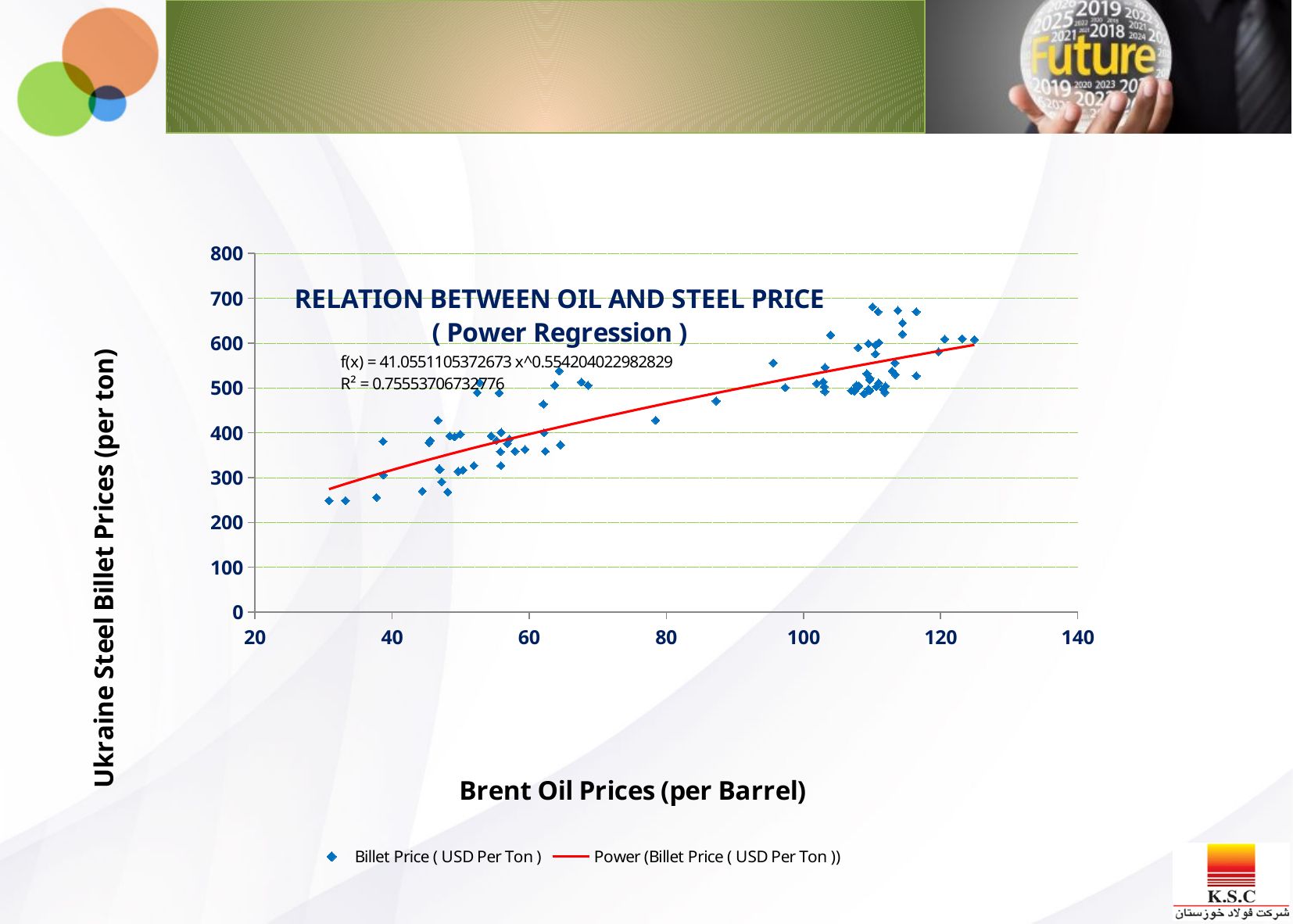
How many entries does the chart legend list? 2 Is the value of the red trendline at an oil price of 40 greater or less than 400? less Do the billet prices generally rise or fall as Brent oil prices increase along the x axis? Rise What is the R² value printed on the chart? 0.75553706732776 What kind of chart is shown on the slide? Scatter chart What is the label of the x axis? Brent Oil Prices (per Barrel) What is the title of the chart? RELATION BETWEEN OIL AND STEEL PRICE ( Power Regression ) Is the highest plotted billet price greater or less than 600? greater Is the lowest plotted billet price greater or less than 300? less What is the highest value shown on the y axis? 800 What regression equation is printed on the chart? f(x) = 41.0551105372673 x^0.554204022982829